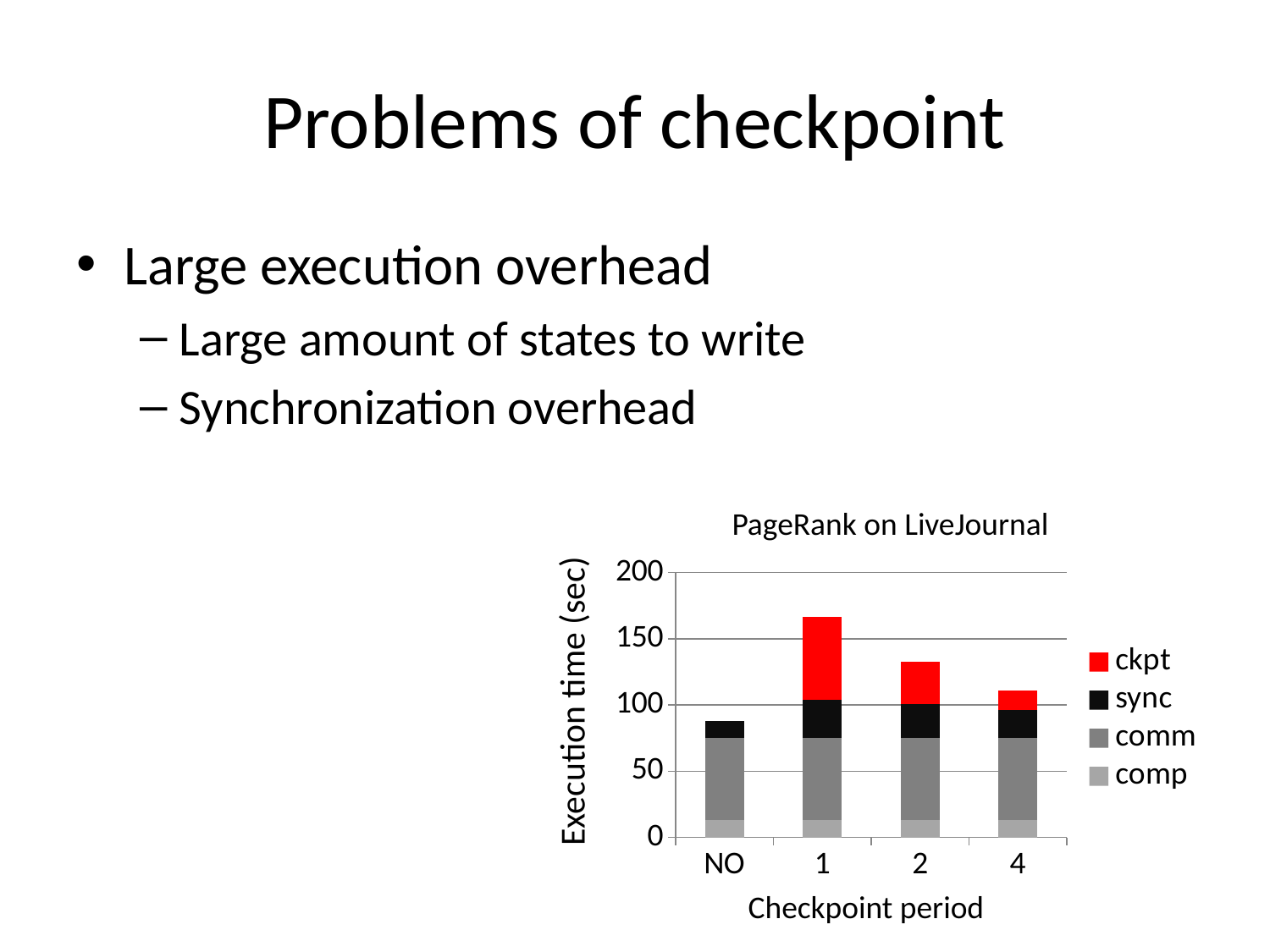
What is the title of the chart? PageRank on LiveJournal Is the total execution time for checkpoint period NO greater or less than 100? less How many series does the legend list? 4 How many checkpoint period categories are shown on the x axis? 4 Which checkpoint period has the highest total execution time? 1 Which checkpoint period has the lowest total execution time? NO Is the total execution time for checkpoint period 1 greater or less than 150? greater From checkpoint period 1 to 4, does the total execution time rise or fall? fall Is the total execution time for checkpoint period 4 greater or less than 100? greater Which has a larger total execution time, checkpoint period 2 or checkpoint period 4? 2 Which series is shown in red in the legend? ckpt What kind of chart is shown on the slide? stacked bar chart